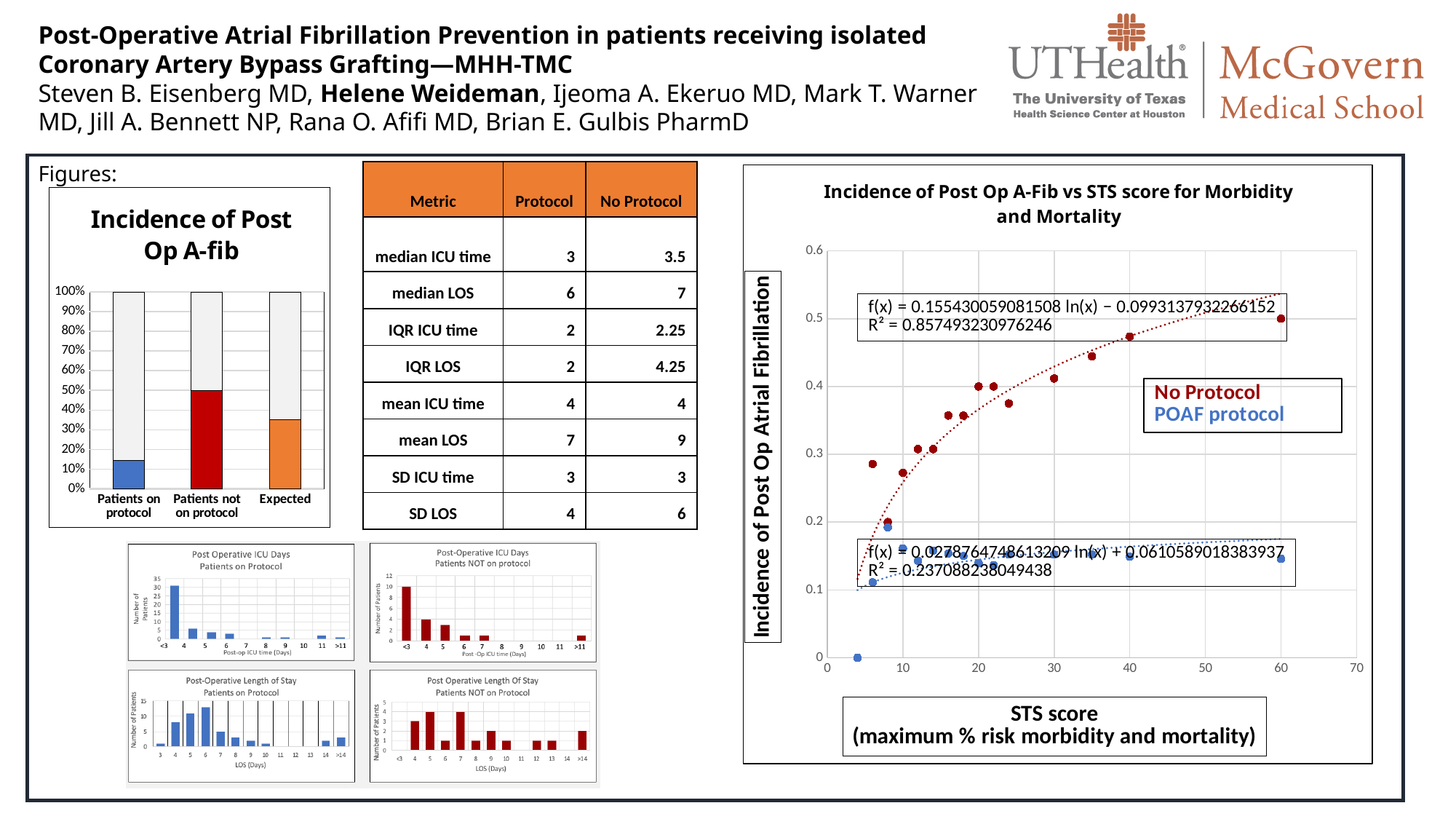
How many series does the legend of the 'Incidence of Post Op A-Fib vs STS score for Morbidity and Mortality' chart list? 2 In the 'Incidence of Post Op A-fib' bar chart, is the value for Expected greater or less than 30%? greater In the 'Incidence of Post Op A-Fib vs STS score for Morbidity and Mortality' chart, what colour are the No Protocol points? red In the 'Incidence of Post Op A-fib' bar chart, which category has the lowest value? Patients on protocol In the 'Post Operative ICU Days Patients on protocol' bar chart, which ICU time category has the highest number of patients? <3 In the 'Incidence of Post Op A-fib' bar chart, which category has the highest value? Patients not on protocol What kind of chart is 'Incidence of Post Op A-Fib vs STS score for Morbidity and Mortality'? scatter chart How many categories are shown in the 'Incidence of Post Op A-fib' bar chart? 3 In the 'Incidence of Post Op A-fib' bar chart, which is larger: the value for Expected or the value for Patients not on protocol? Patients not on protocol In the 'Incidence of Post Op A-Fib vs STS score for Morbidity and Mortality' chart, what is the R² value shown for the POAF protocol trendline? 0.237088238049438 In the 'Incidence of Post Op A-fib' bar chart, is the value for Patients on protocol greater or less than 20%? less In the 'Incidence of Post Op A-Fib vs STS score for Morbidity and Mortality' chart, what is the R² value shown for the No Protocol trendline? 0.857493230976246